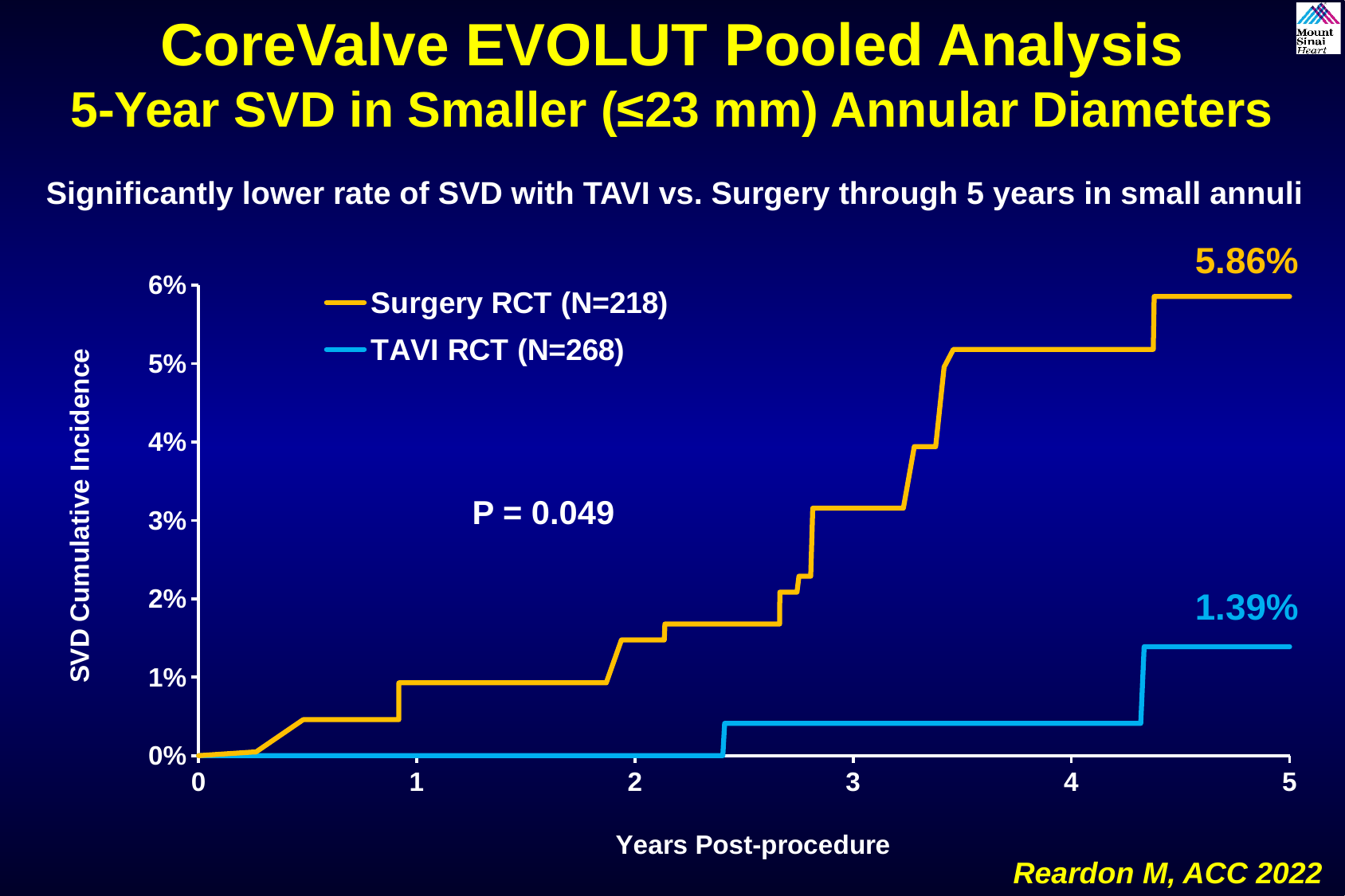
What is the 5-year SVD cumulative incidence for the TAVI RCT group? 1.39% How many series does the legend list? 2 What is the 5-year SVD cumulative incidence for the Surgery RCT group? 5.86% What is the P value shown on the chart? P = 0.049 What is the difference between the Surgery RCT and TAVI RCT 5-year SVD cumulative incidence values? 4.47% What is the label of the x axis? Years Post-procedure Which group has the higher SVD cumulative incidence at 5 years? Surgery RCT What kind of chart is shown on the slide? Line chart Is the TAVI RCT SVD cumulative incidence at 4 years greater or less than 1%? less What is the sample size (N) of the TAVI RCT group shown in the legend? 268 Does the Surgery RCT SVD cumulative incidence rise or fall over the years post-procedure? rise Is the Surgery RCT SVD cumulative incidence at 3 years greater or less than 2%? greater